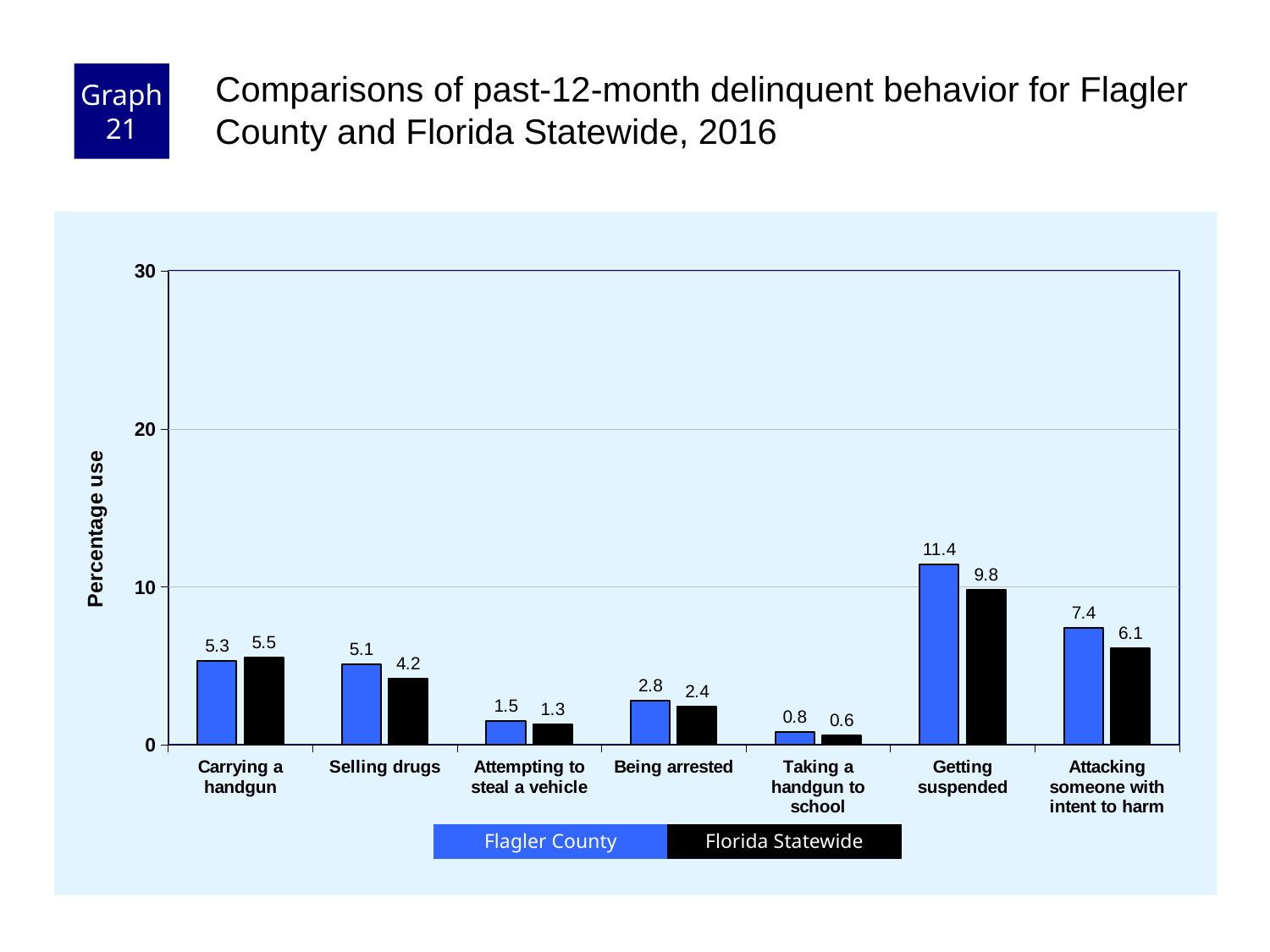
What is the difference between the Flagler County and Florida Statewide values for Attacking someone with intent to harm? 1.3 For Carrying a handgun, which is larger: the Flagler County value or the Florida Statewide value? Florida Statewide What is the Florida Statewide value for Selling drugs? 4.2 What is the Flagler County value for Taking a handgun to school? 0.8 What is the label of the y axis? Percentage use Which category has the highest Florida Statewide value? Getting suspended How many categories are shown on the x axis? 7 Is the Flagler County value for Getting suspended greater or less than 10? greater How many series does the legend list? 2 Which category has the lowest Flagler County value? Taking a handgun to school What kind of chart is shown on the slide? bar chart What is the Flagler County value for Getting suspended? 11.4